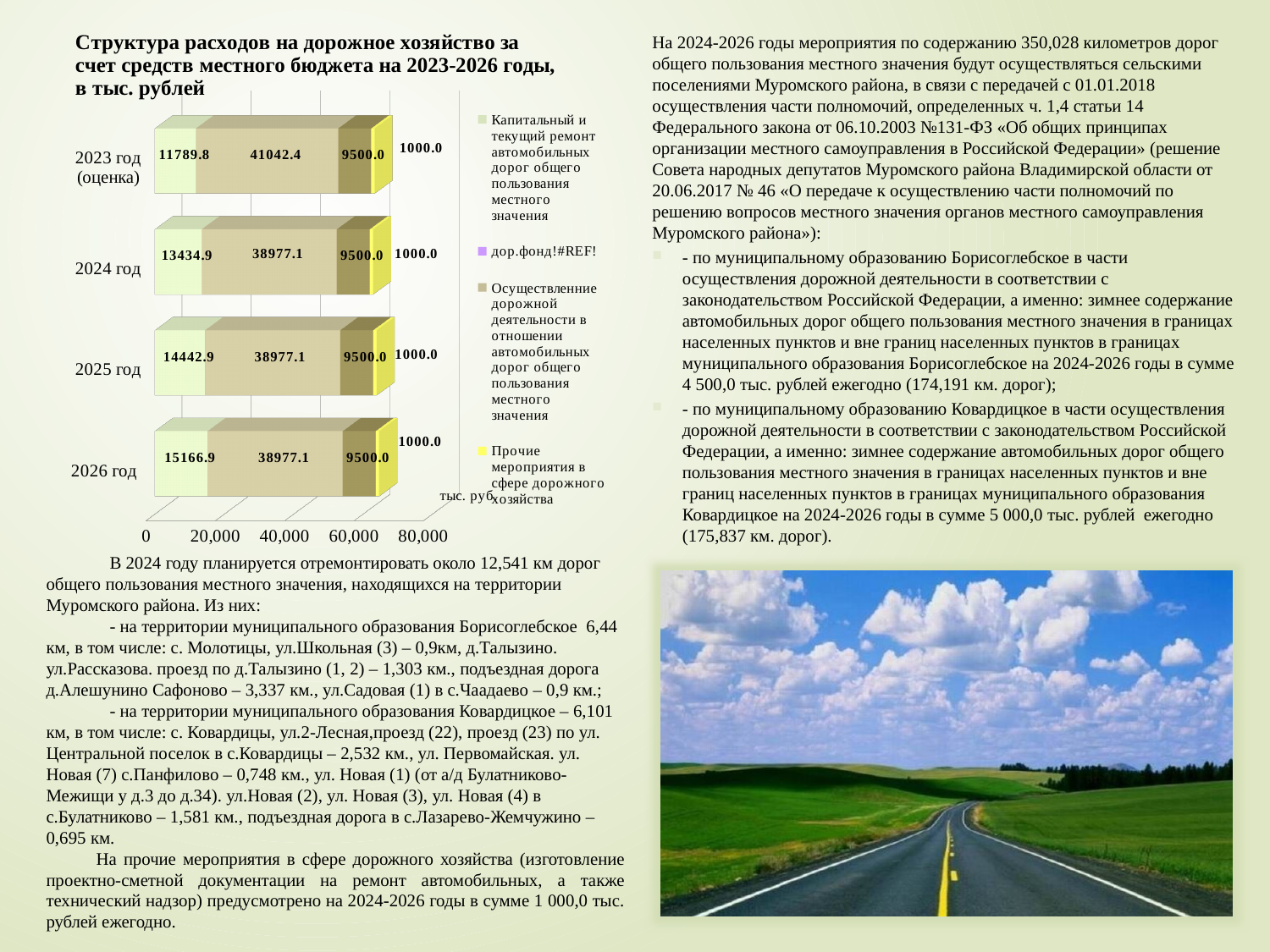
What is the difference between the first-segment values for 2026 год and 2023 год (оценка)? 3377.1 What is the total of the stacked bar for 2024 год? 62912.0 How many series does the chart legend list? 4 Does the first (leftmost) segment value rise or fall from 2023 to 2026? Rise How many year categories does the chart show? 4 Which year has the highest value for the first (leftmost) segment? 2026 год What is the value for 'Прочие мероприятия в сфере дорожного хозяйства' in 2026 год? 1000.0 What is the value of the first (leftmost) segment for 2023 год (оценка)? 11789.8 What is the value of the second segment for 2024 год? 38977.1 Which year has the lowest value for the first (leftmost) segment? 2023 год (оценка) What is the value for 'Осуществление дорожной деятельности в отношении автомобильных дорог общего пользования местного значения' in 2025 год? 38977.1 What kind of chart is shown on the slide? Stacked bar chart